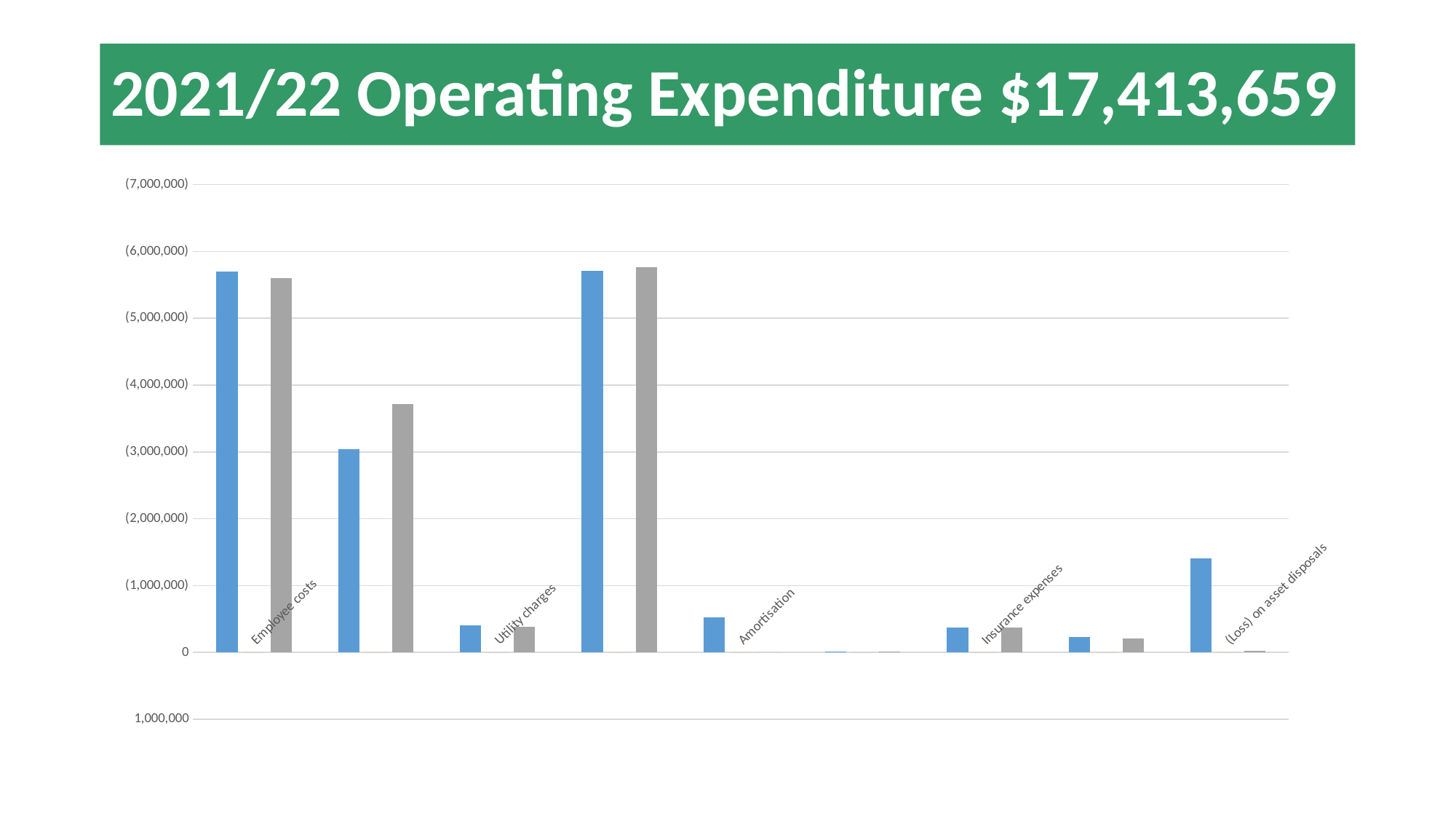
How many groups of bars are plotted along the x axis? 9 Among the labelled categories, which has the largest blue bar? Employee costs Is the value of the blue bar for Utility charges greater or less than 1,000,000 in magnitude? less Is the value of the blue bar for Amortisation greater or less than 1,000,000 in magnitude? less How many series (bar colours) are plotted in the chart? 2 Is the value of the blue bar for Employee costs greater or less than 5,000,000 in magnitude? greater Which has the larger blue bar, Employee costs or Utility charges? Employee costs What kind of chart is shown on the slide? bar chart How many category labels are readable on the x axis? 5 What is the title of the slide? 2021/22 Operating Expenditure $17,413,659 What two colours are used for the bars in the chart? blue and gray